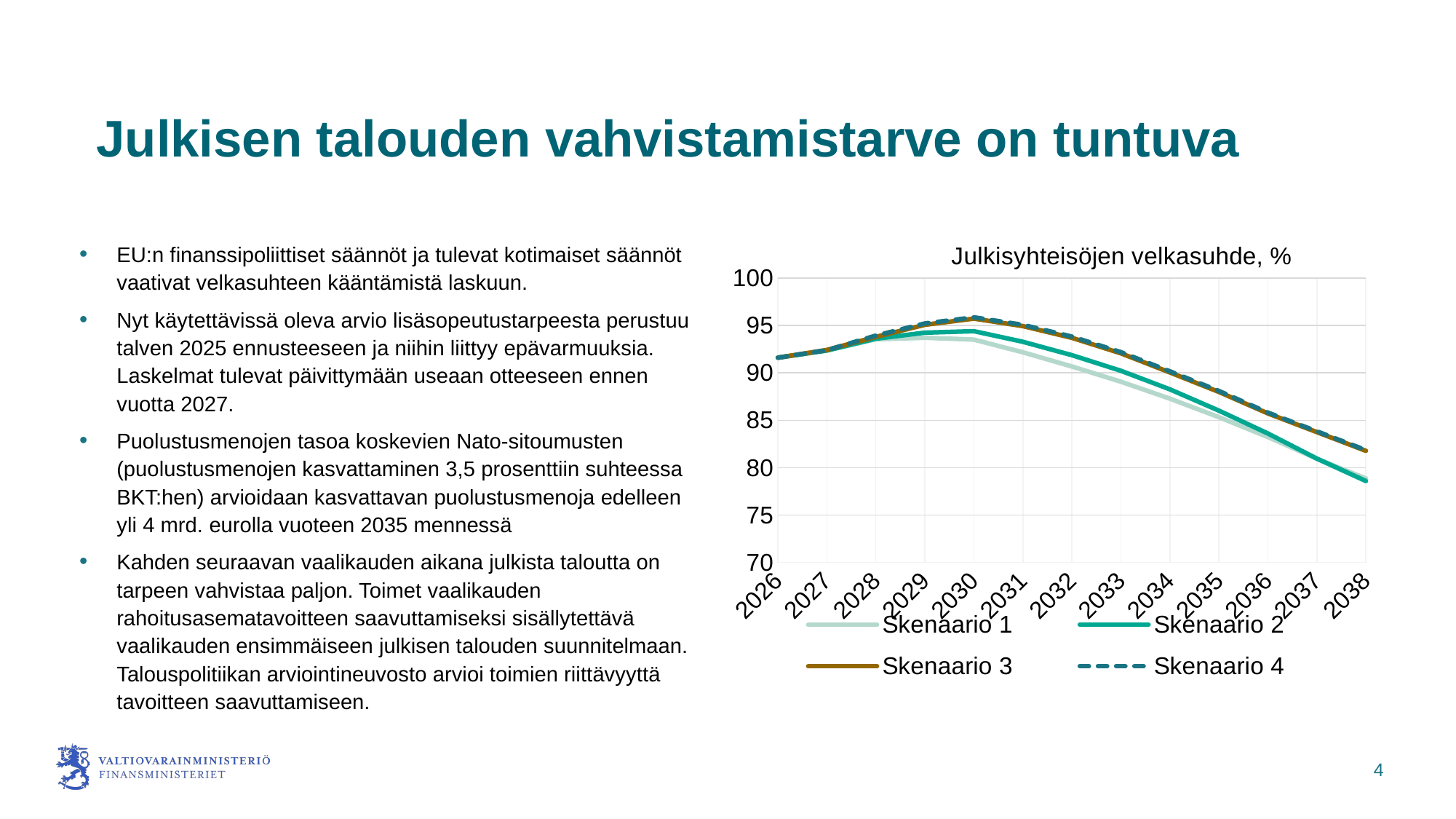
Do the values for Skenaario 3 rise or fall from 2030 to 2038? fall Is the value for Skenaario 2 in 2035 greater or less than 90? less How many series does the legend of the chart list? 4 In which year does Skenaario 4 reach its highest value? 2030 Is the value for Skenaario 3 in 2038 greater or less than 80? greater Is the value for Skenaario 1 in 2038 greater or less than 80? less Which series in the legend is drawn with a dashed line? Skenaario 4 What is the title of the chart? Julkisyhteisöjen velkasuhde, % How many years are shown on the x axis of the chart? 13 Which scenario has the lowest value in 2033? Skenaario 1 What kind of chart is shown on the slide? line chart